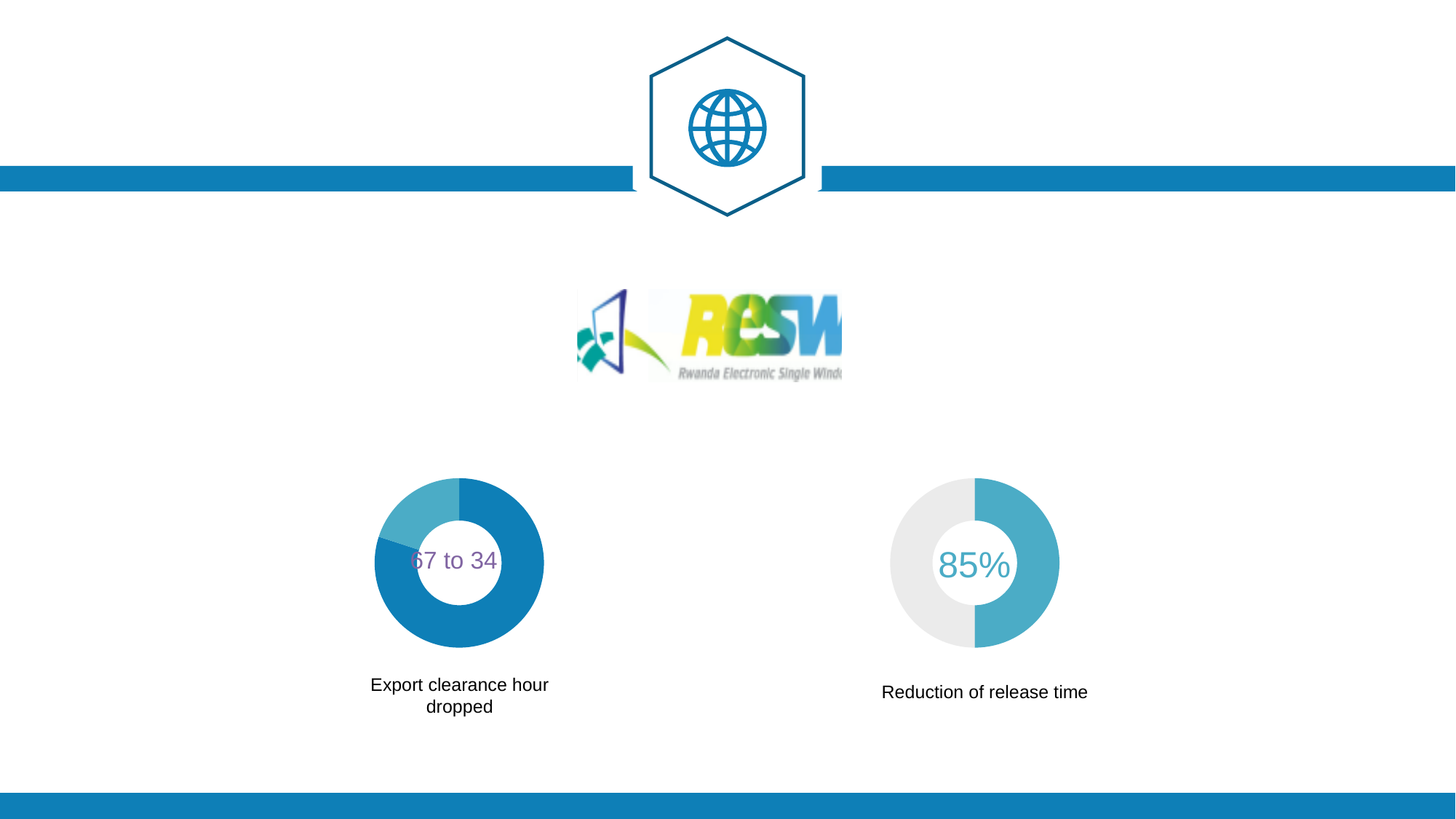
How many slices does the right chart (Reduction of release time) have? 2 In the left chart (Export clearance hour dropped), which slice is larger, the dark blue one or the light blue one? dark blue How many donut charts are shown on the slide? 2 How many slices does the left chart (Export clearance hour dropped) have? 2 What kind of chart is shown on the right of the slide, above the caption 'Reduction of release time'? donut chart In the left chart (Export clearance hour dropped), what text is printed in the centre of the donut? 67 to 34 What is the caption below the right donut chart? Reduction of release time In the left chart, export clearance hours dropped from 67 to 34; by how many hours did they drop? 33 In the right chart (Reduction of release time), what value is printed in the centre of the donut? 85% What is the caption below the left donut chart? Export clearance hour dropped What kind of chart is shown on the left of the slide, above the caption 'Export clearance hour dropped'? donut chart